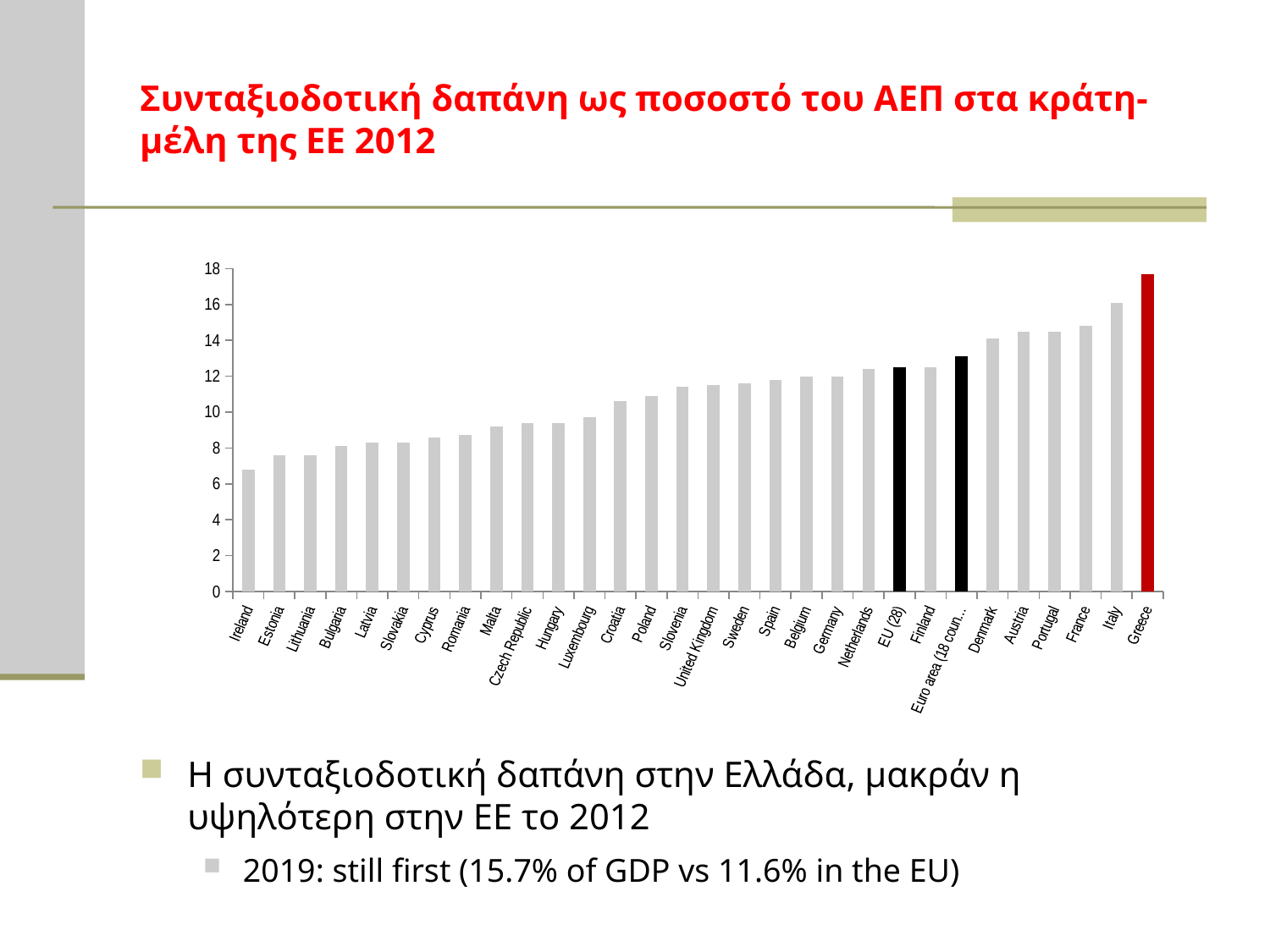
Is the value for Croatia greater or less than 12? less Which is larger, the value for France or the value for Estonia? France Which is larger, the value for Denmark or the value for Hungary? Denmark What kind of chart is shown on the slide? bar chart Which country has the highest pension expenditure as a share of GDP in the chart? Greece Which country has the lowest value in the chart? Ireland Do the bar values rise or fall moving from left to right along the x axis? rise Is the value for Italy greater or less than 14? greater What colour is the bar for Greece? red Is the value for Ireland greater or less than 8? less How many bars (categories) are plotted in the chart? 30